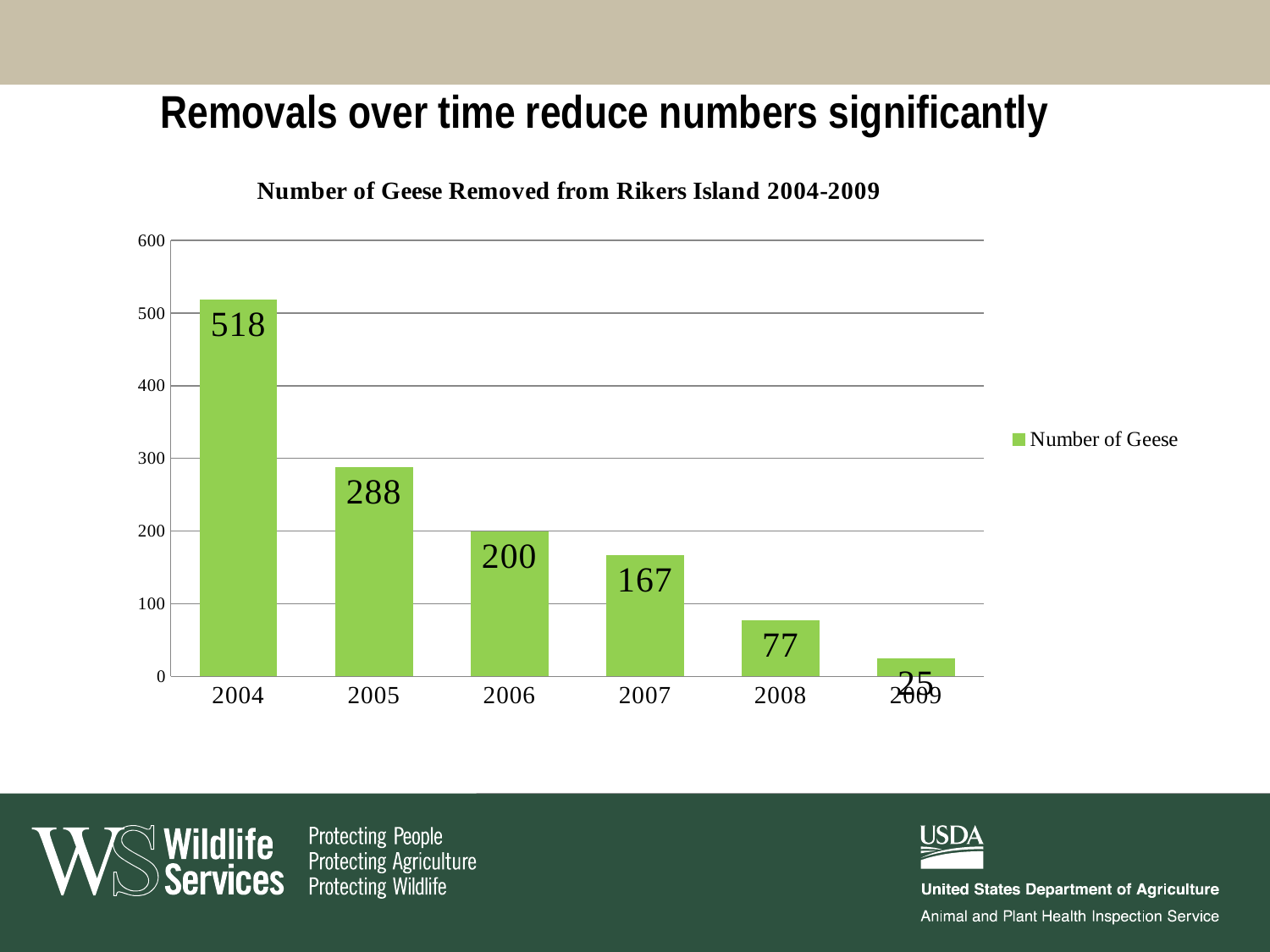
How many years are shown on the x axis of the chart? 6 How many geese were removed in 2009? 25 What kind of chart is shown on the slide? bar chart What is the difference between the number of geese removed in 2004 and in 2005? 230 Do the values rise or fall from 2004 to 2009? fall Which year had the highest number of geese removed? 2004 Which year had more geese removed, 2006 or 2008? 2006 Is the value for 2005 greater or less than 300? less How many geese were removed from Rikers Island in 2004? 518 What is the value for 2007 in the Number of Geese chart? 167 How many series does the legend list? 1 Which year had the lowest number of geese removed? 2009